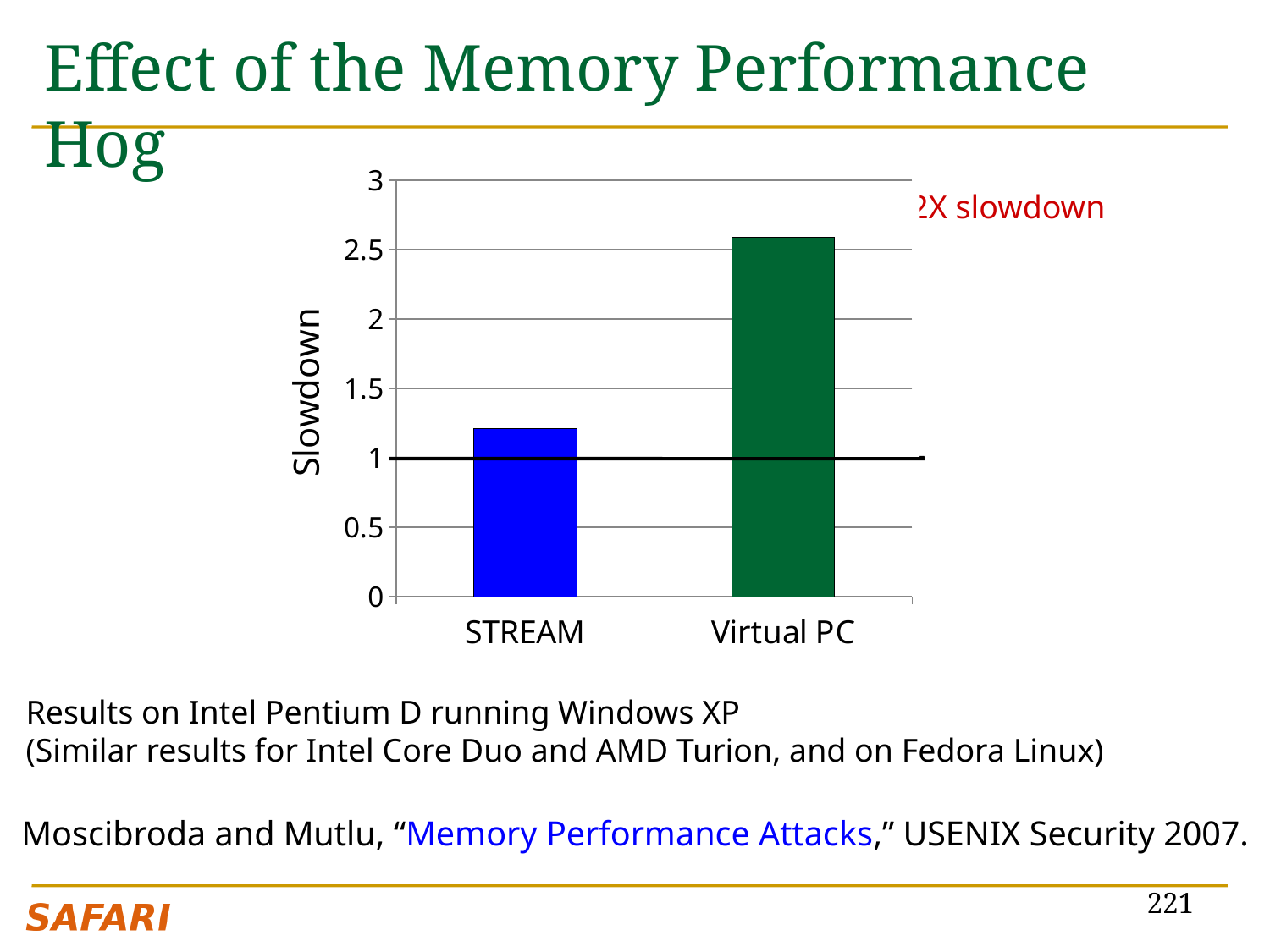
How many categories are plotted on the x axis of the chart? 2 Is the slowdown for STREAM greater or less than 1? greater What colour is the bar for Virtual PC? green Is the slowdown for Virtual PC greater or less than 2.5? greater Which category has the highest slowdown in the chart? Virtual PC Which category has the lowest slowdown in the chart? STREAM Is the slowdown for Virtual PC greater or less than 3? less Which has a larger slowdown, STREAM or Virtual PC? Virtual PC What is the label of the y axis of the chart? Slowdown What kind of chart is shown on the slide? bar chart